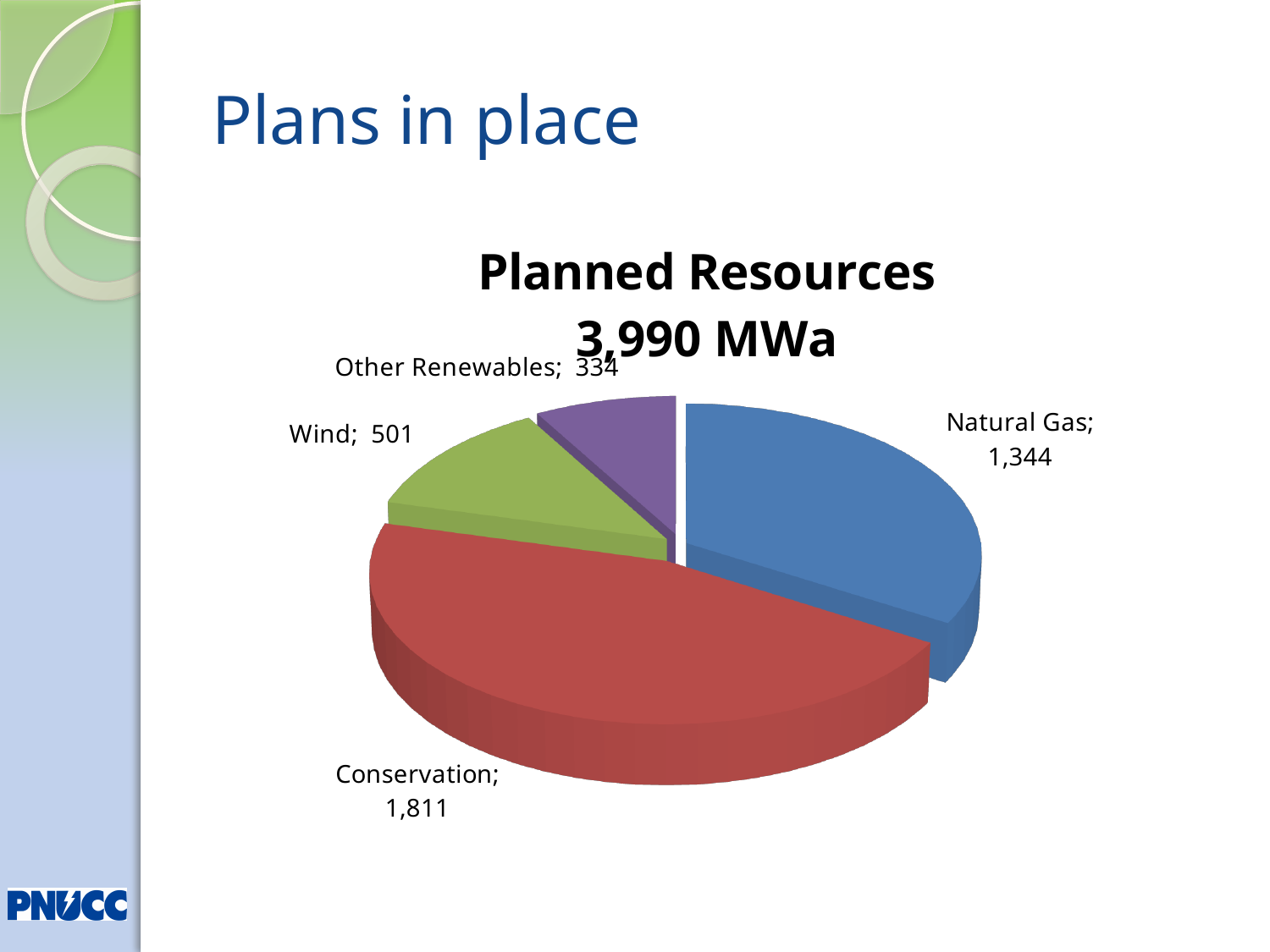
What type of chart is shown on the slide? Pie chart What is the value for Wind in the Planned Resources pie chart? 501 What total is stated in the title of the Planned Resources pie chart? 3,990 MWa Which category has the smallest slice in the Planned Resources pie chart? Other Renewables What is the difference between the Conservation and Natural Gas values in the Planned Resources pie chart? 467 What is the value for Other Renewables in the Planned Resources pie chart? 334 Which is larger in the Planned Resources pie chart, Wind or Other Renewables? Wind How many slices does the Planned Resources pie chart have? 4 What is the value for Natural Gas in the Planned Resources pie chart? 1,344 What colour is the Conservation slice in the Planned Resources pie chart? Red What is the value for Conservation in the Planned Resources pie chart? 1,811 Which category has the largest slice in the Planned Resources pie chart? Conservation